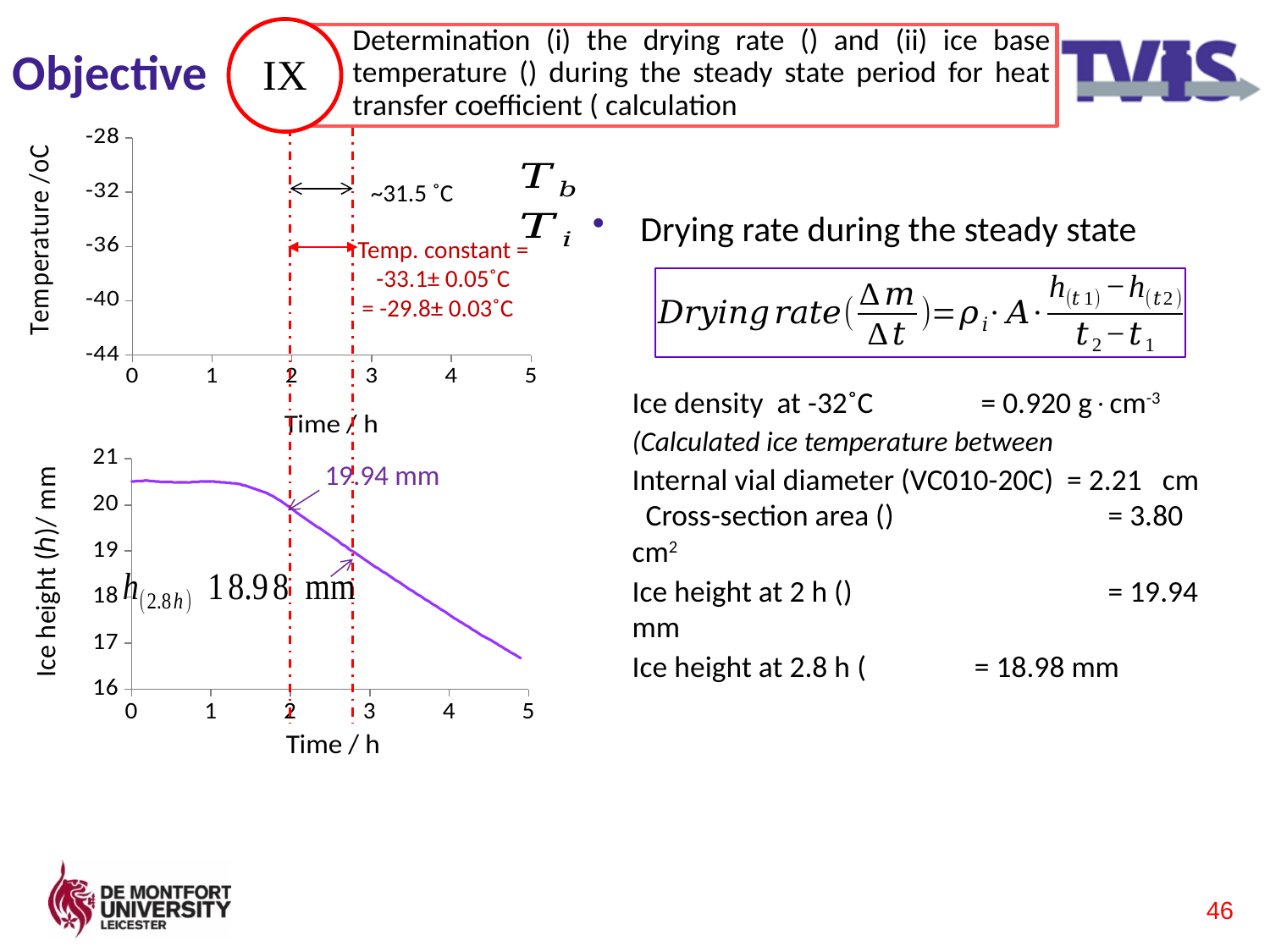
In the bottom chart (Ice height vs Time), what is the ice height at 2 h? 19.94 mm In the bottom chart (Ice height vs Time), what is the difference between the ice height at 2 h and at 2.8 h? 0.96 mm In the bottom chart (Ice height vs Time), is the ice height at 1 h greater or less than 20 mm? greater In the bottom chart (Ice height vs Time), does the ice height rise or fall as time increases from 2 h to 5 h? fall In the bottom chart (Ice height vs Time), is the ice height at 4 h greater or less than 18 mm? less In the bottom chart (Ice height vs Time), what kind of chart is it? line chart In the bottom chart, what is the label of the x axis? Time / h In the bottom chart (Ice height vs Time), what is the ice height at 2.8 h? 18.98 mm In the bottom chart (Ice height vs Time), is the ice height at 3 h greater or less than 19 mm? less In the bottom chart (Ice height vs Time), which is larger, the ice height at 2 h or at 2.8 h? 2 h In the top chart, what is the label of the y axis? Temperature /oC